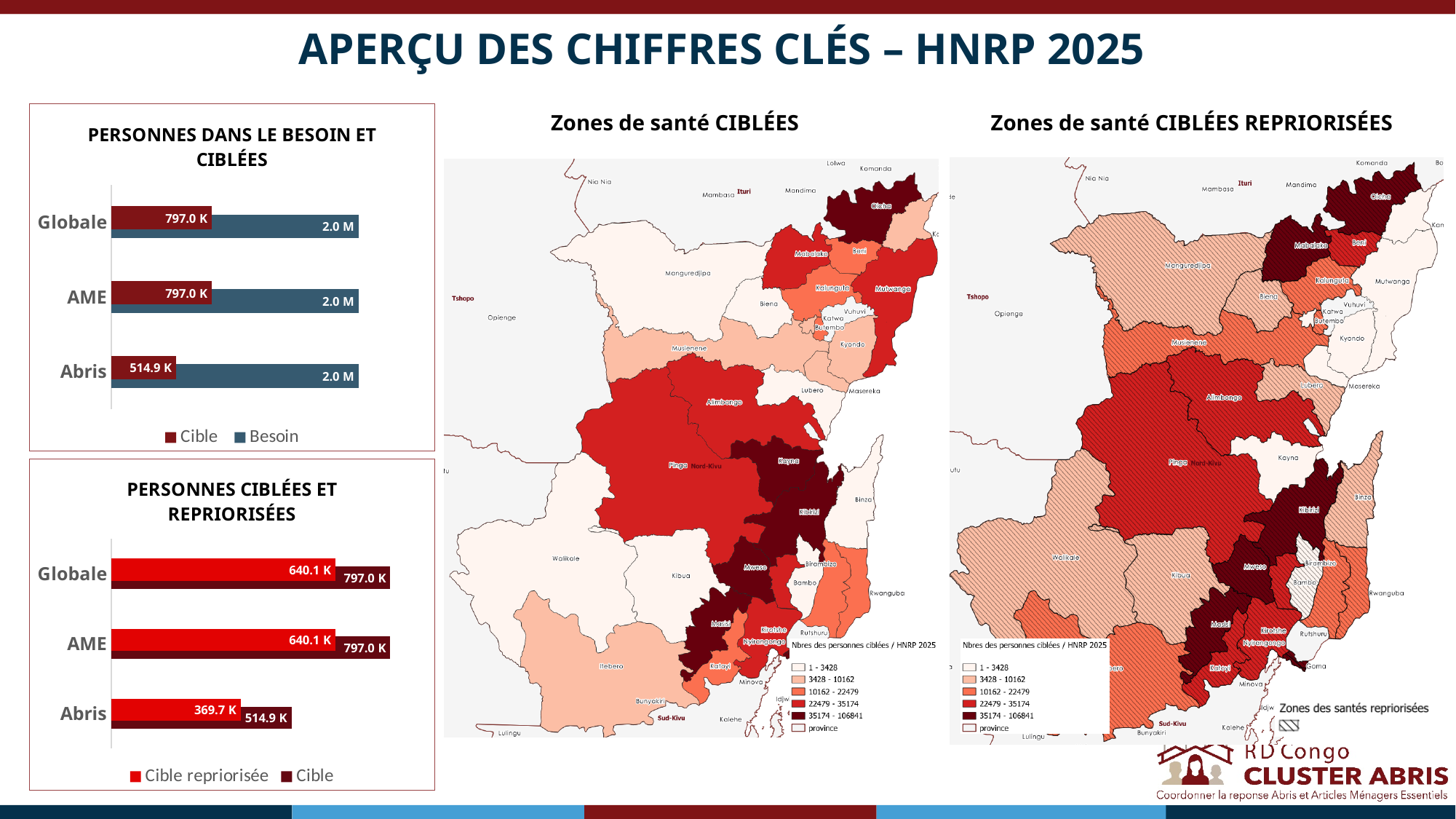
In the chart 'PERSONNES DANS LE BESOIN ET CIBLÉES', what is the Besoin value for Globale? 2.0 M How many categories are shown in the chart 'PERSONNES CIBLÉES ET REPRIORISÉES'? 3 In the chart 'PERSONNES DANS LE BESOIN ET CIBLÉES', what is the Cible value for Abris? 514.9 K What kind of chart is 'PERSONNES DANS LE BESOIN ET CIBLÉES'? Bar chart In the chart 'PERSONNES CIBLÉES ET REPRIORISÉES', what is the Cible value for AME? 797.0 K In the chart 'PERSONNES CIBLÉES ET REPRIORISÉES', what is the difference between the Cible and Cible repriorisée values for Globale? 156.9 K In the chart 'PERSONNES CIBLÉES ET REPRIORISÉES', what is the Cible repriorisée value for Abris? 369.7 K In the chart 'PERSONNES CIBLÉES ET REPRIORISÉES', which is larger for Abris: Cible repriorisée or Cible? Cible In the chart 'PERSONNES CIBLÉES ET REPRIORISÉES', which category has the lowest Cible repriorisée value? Abris In the chart 'PERSONNES DANS LE BESOIN ET CIBLÉES', what is the difference between the Cible values for AME and Abris? 282.1 K In the chart 'PERSONNES DANS LE BESOIN ET CIBLÉES', how many series does the legend list? 2 In the chart 'PERSONNES DANS LE BESOIN ET CIBLÉES', which category has the lowest Cible value? Abris